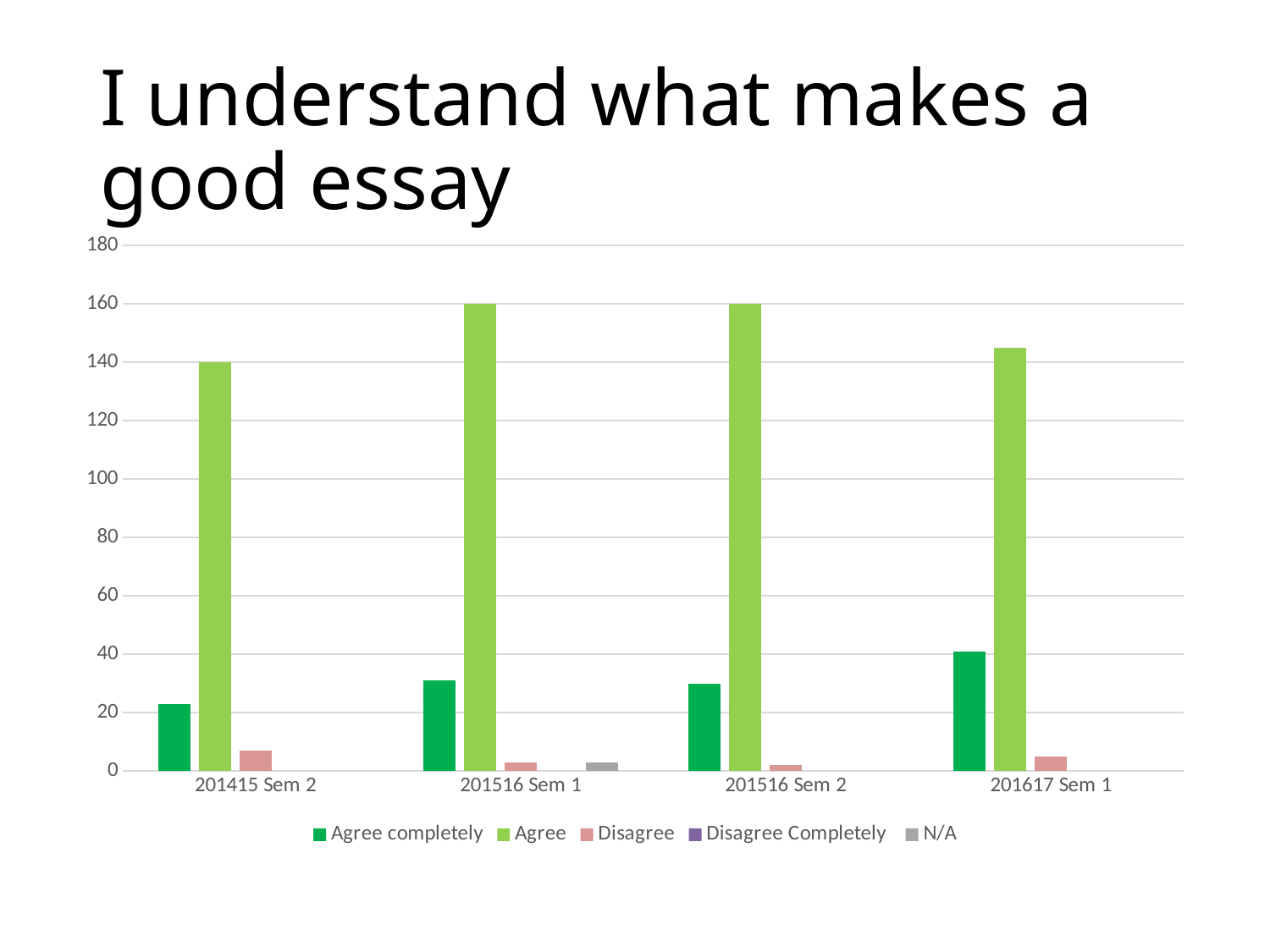
What kind of chart is shown on the slide? Bar chart In which category is the Agree completely value lowest? 201415 Sem 2 In which category is the Agree completely value highest? 201617 Sem 1 What is the title of the chart? I understand what makes a good essay Is the value for Agree completely in 201617 Sem 1 greater or less than 20? greater What is the value for Agree in 201415 Sem 2? 140 What is the value for Agree in 201516 Sem 2? 160 How many categories are shown on the x axis? 4 How many series does the legend list? 5 Is the value for Agree in 201617 Sem 1 greater or less than 160? less Which is larger in 201415 Sem 2: Disagree or Agree completely? Agree completely What is the value for Agree in 201516 Sem 1? 160